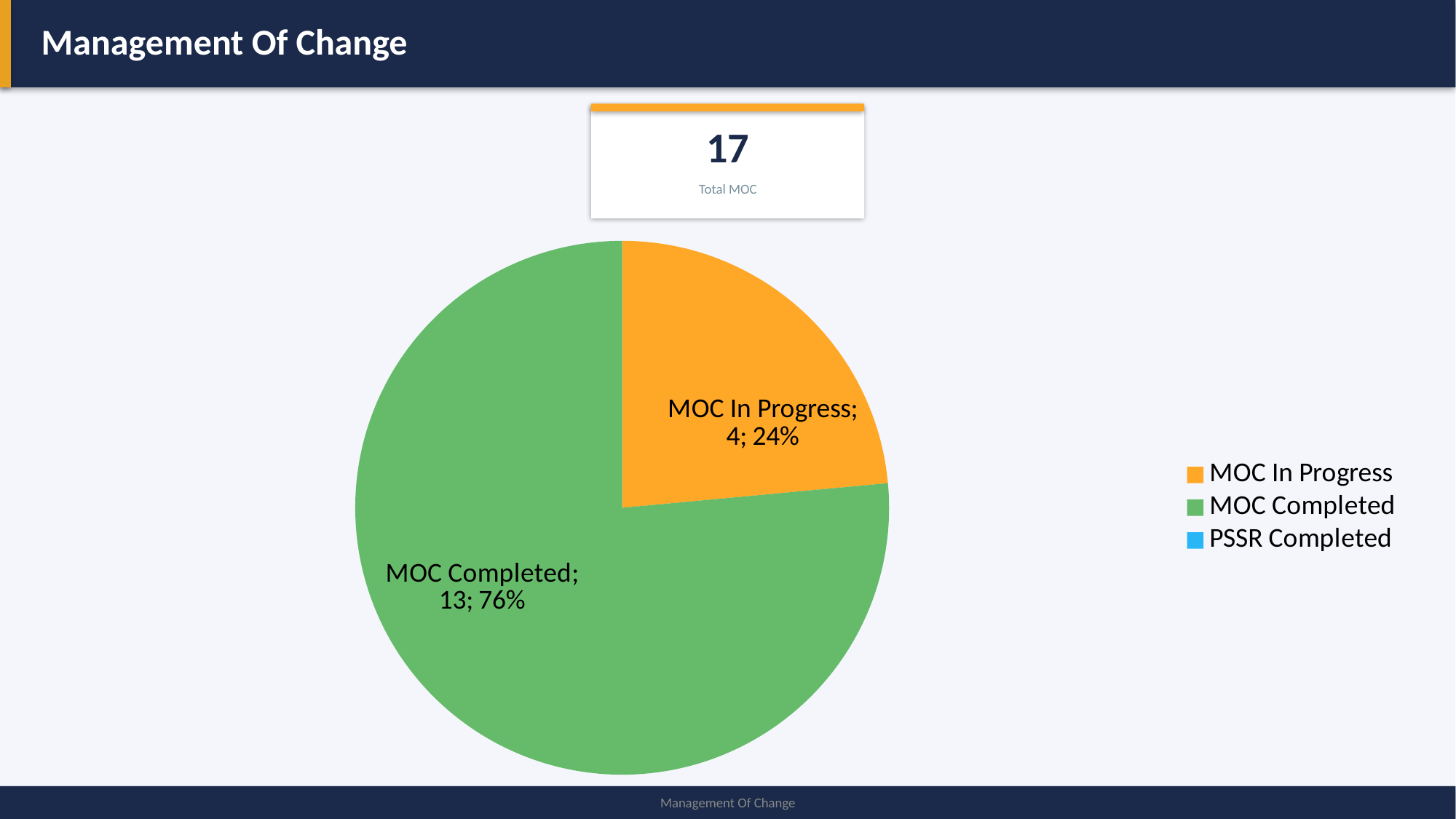
What is the difference between the MOC Completed count and the MOC In Progress count? 9 What is the Total MOC shown on the slide? 17 What kind of chart is shown on the slide? pie chart How many MOC Completed are shown in the pie chart? 13 What colour is the MOC Completed slice? green What share of the pie does MOC In Progress represent? 24% Which of the two visible slices is the smallest? MOC In Progress What share of the pie does MOC Completed represent? 76% Which slice of the pie chart is the largest? MOC Completed How many entries does the legend list? 3 Which is larger, MOC Completed or MOC In Progress? MOC Completed How many MOC In Progress are shown in the pie chart? 4